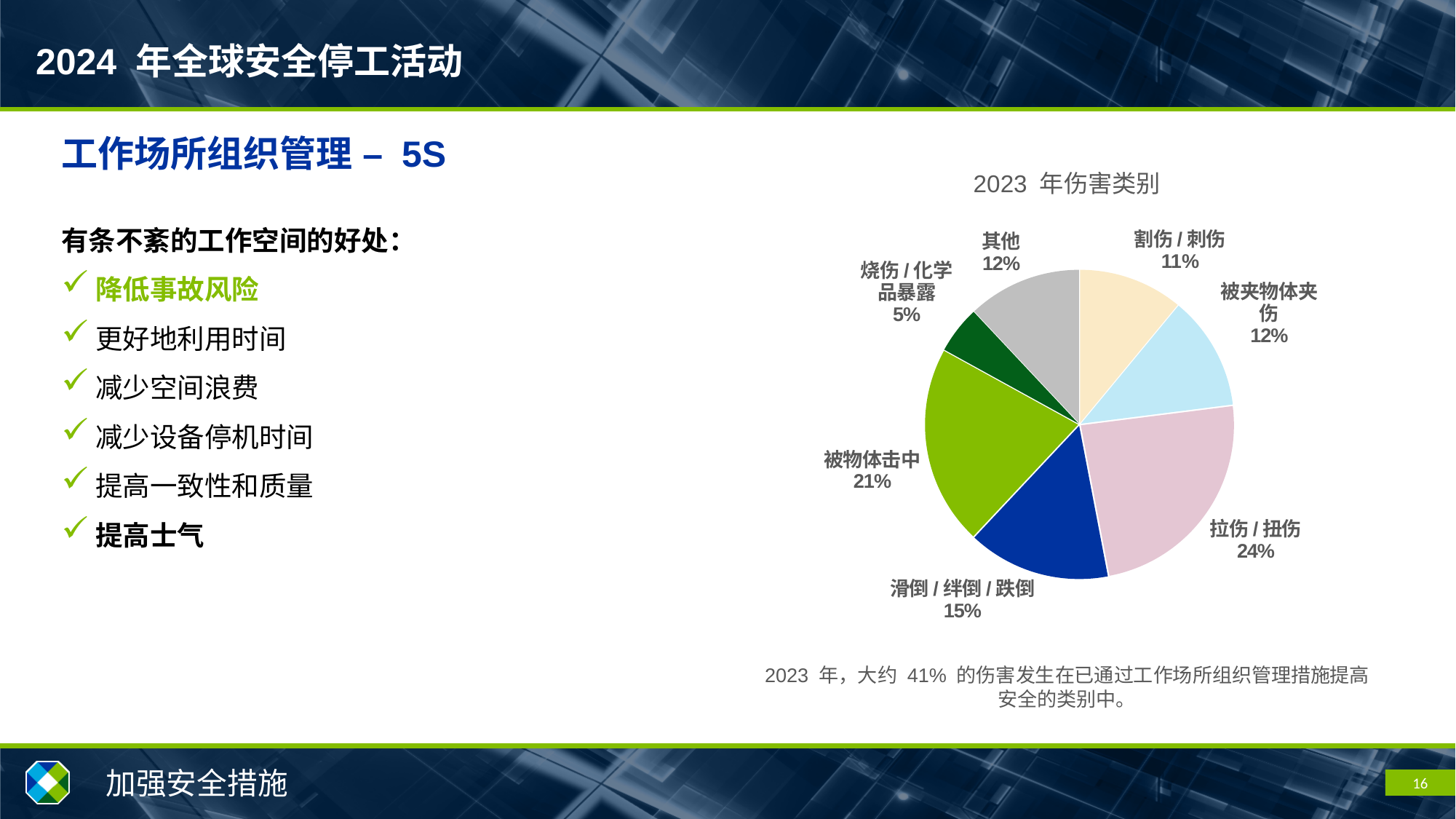
What is the title of the chart? 2023 年伤害类别 What percentage of injuries is attributed to 烧伤 / 化学品暴露? 5% Which injury category has the smallest share of the pie? 烧伤 / 化学品暴露 Which is larger, the share for 被物体击中 or the share for 滑倒 / 绊倒 / 跌倒? 被物体击中 What is the combined share of 其他 and 被夹物体夹伤? 24% What percentage of injuries is attributed to 滑倒 / 绊倒 / 跌倒? 15% How many injury categories are shown in the pie chart? 7 What type of chart is shown on the slide? Pie chart What percentage of injuries is attributed to 被物体击中? 21% Which injury category has the largest share of the pie? 拉伤 / 扭伤 What percentage of injuries is attributed to 拉伤 / 扭伤? 24% What is the difference in percentage points between 拉伤 / 扭伤 and 割伤 / 刺伤? 13%